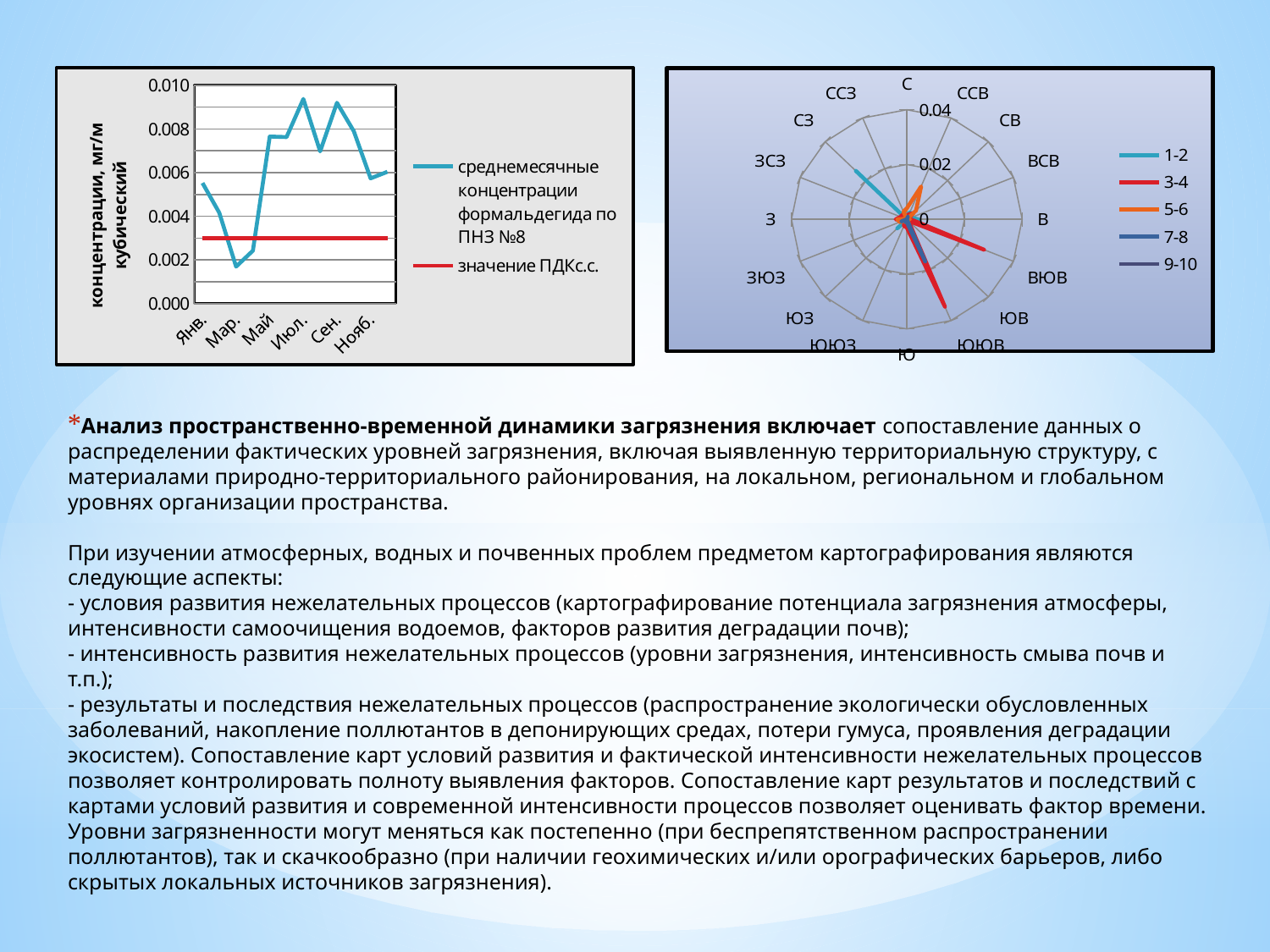
What type of chart is the right chart on the slide? radar chart How many series does the legend of the left chart list? 2 In the left chart, is the value of среднемесячные концентрации формальдегида for Июл. greater or less than 0.008? greater In the left chart, is the value of среднемесячные концентрации формальдегида for Мар. greater or less than 0.004? less In the left chart, which series is higher at Май: среднемесячные концентрации формальдегида по ПНЗ №8 or значение ПДКс.с.? среднемесячные концентрации формальдегида по ПНЗ №8 In the left chart, is the value of среднемесячные концентрации формальдегида for Янв. greater or less than 0.004? greater What type of chart is the left chart on the slide? line chart What is the y-axis title of the left chart? концентрации, мг/м кубический How many direction categories are plotted around the right chart? 16 How many series does the legend of the right chart list? 5 In the left chart, does the среднемесячные концентрации формальдегида line rise or fall between Мар. and Июл.? rise